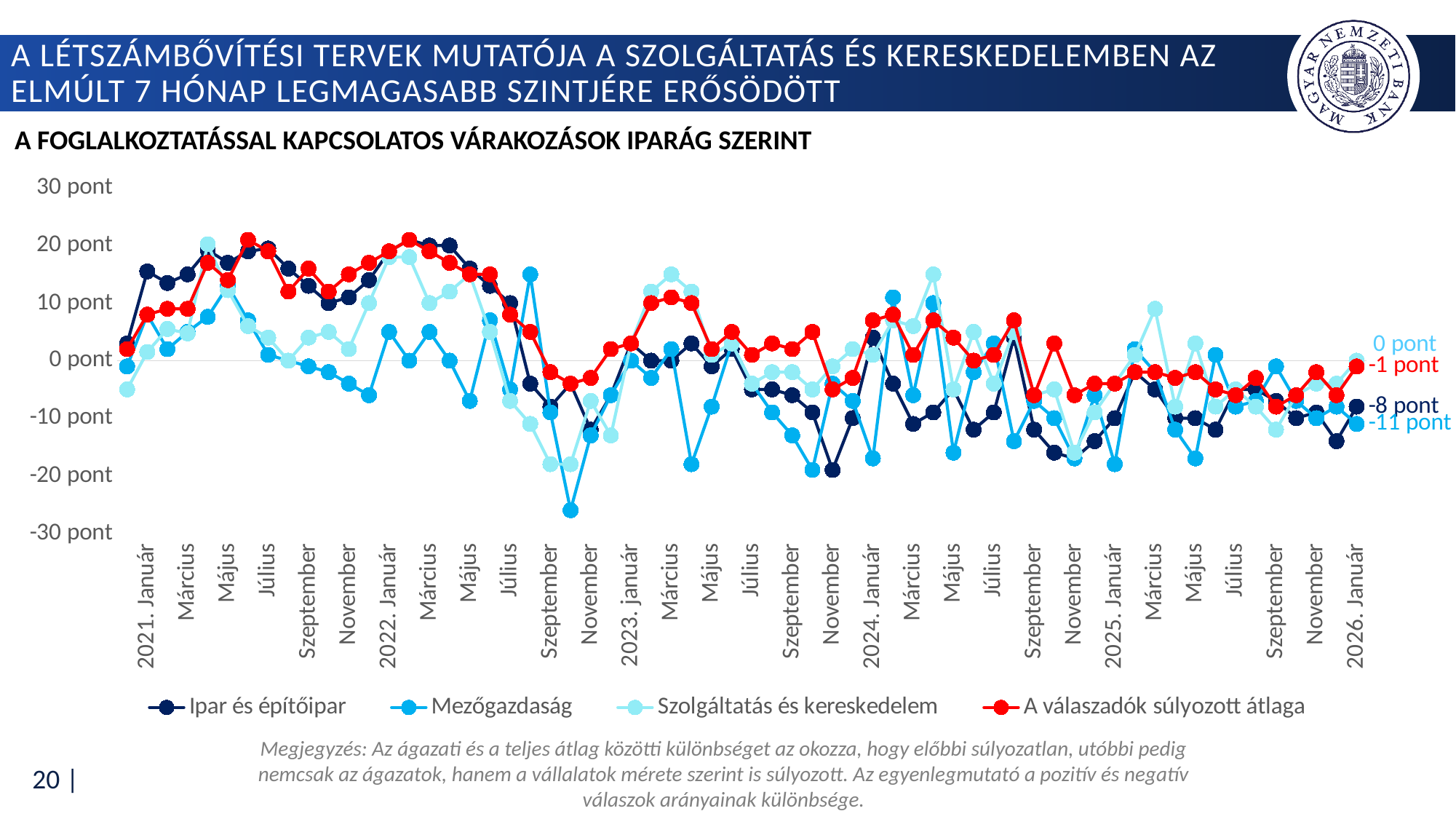
What colour is the line for A válaszadók súlyozott átlaga? red How many series does the legend list? 4 What is the value for Ipar és építőipar in 2026. Január? -8 pont What is the value for Szolgáltatás és kereskedelem in 2026. Január? 0 pont What is the value for A válaszadók súlyozott átlaga in 2026. Január? -1 pont In 2026. Január, which is higher: Ipar és építőipar or Mezőgazdaság? Ipar és építőipar Which series has the lowest value in 2026. Január? Mezőgazdaság What kind of chart is shown on the slide? line chart What is the value for Mezőgazdaság in 2026. Január? -11 pont Which series has the highest value in 2026. Január? Szolgáltatás és kereskedelem What is the difference between the Szolgáltatás és kereskedelem and Mezőgazdaság values in 2026. Január? 11 pont